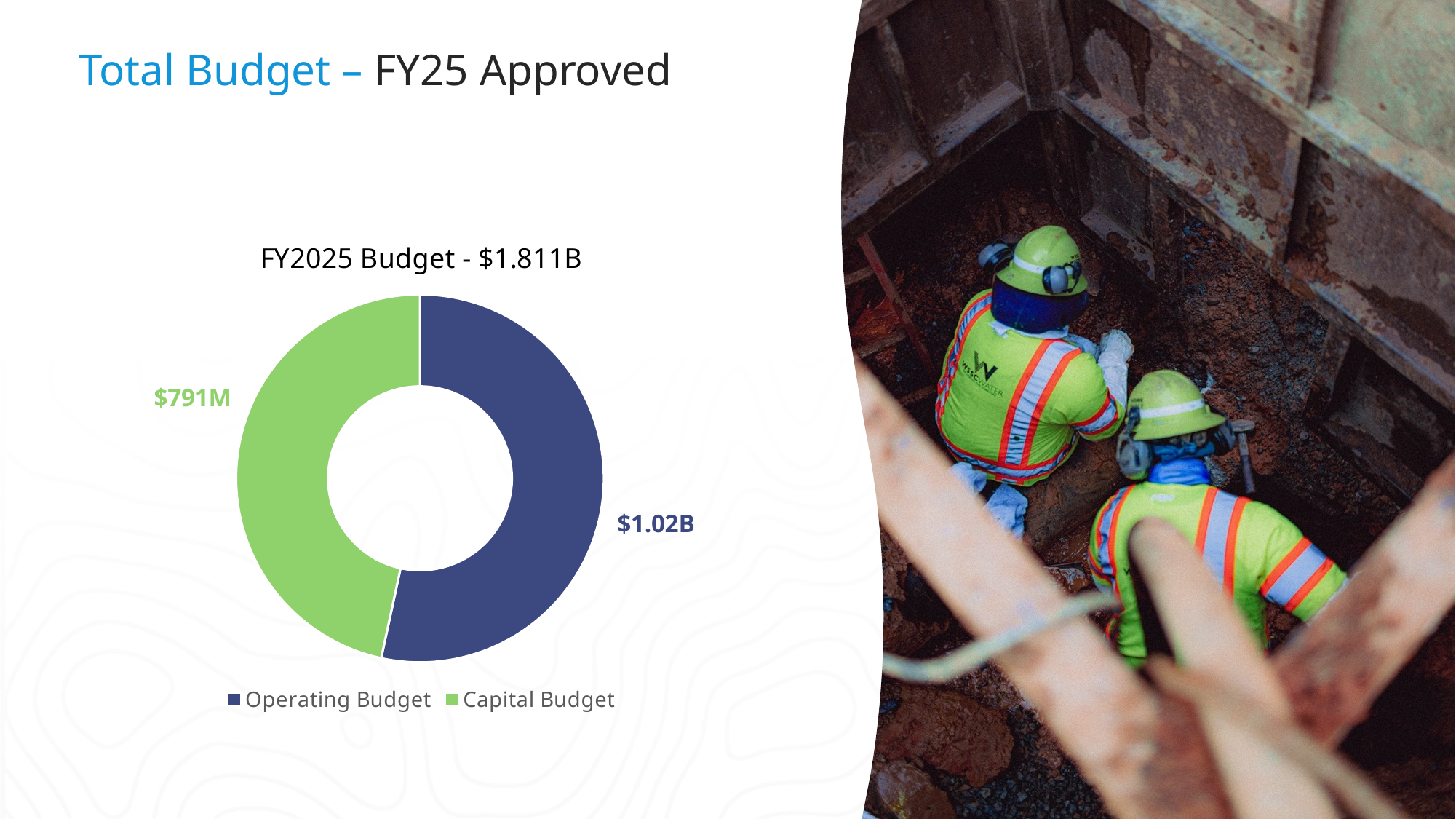
What is the title of the chart on the slide? FY2025 Budget - $1.811B What is the difference between the Operating Budget ($1.02B) and the Capital Budget ($791M) in the FY2025 Budget chart? $229M Which slice of the FY2025 Budget chart is the smallest? Capital Budget How many entries does the legend of the FY2025 Budget chart list? 2 What is the value of the Capital Budget slice in the FY2025 Budget chart? $791M What kind of chart is used to show the FY2025 Budget? Pie (donut) chart What total budget is stated in the title of the FY2025 Budget chart? $1.811B Which is larger in the FY2025 Budget chart, the Operating Budget or the Capital Budget? Operating Budget How many slices does the FY2025 Budget chart have? 2 Which colour represents the Capital Budget in the FY2025 Budget chart? Green What is the value of the Operating Budget slice in the FY2025 Budget chart? $1.02B Which slice of the FY2025 Budget chart is the largest? Operating Budget